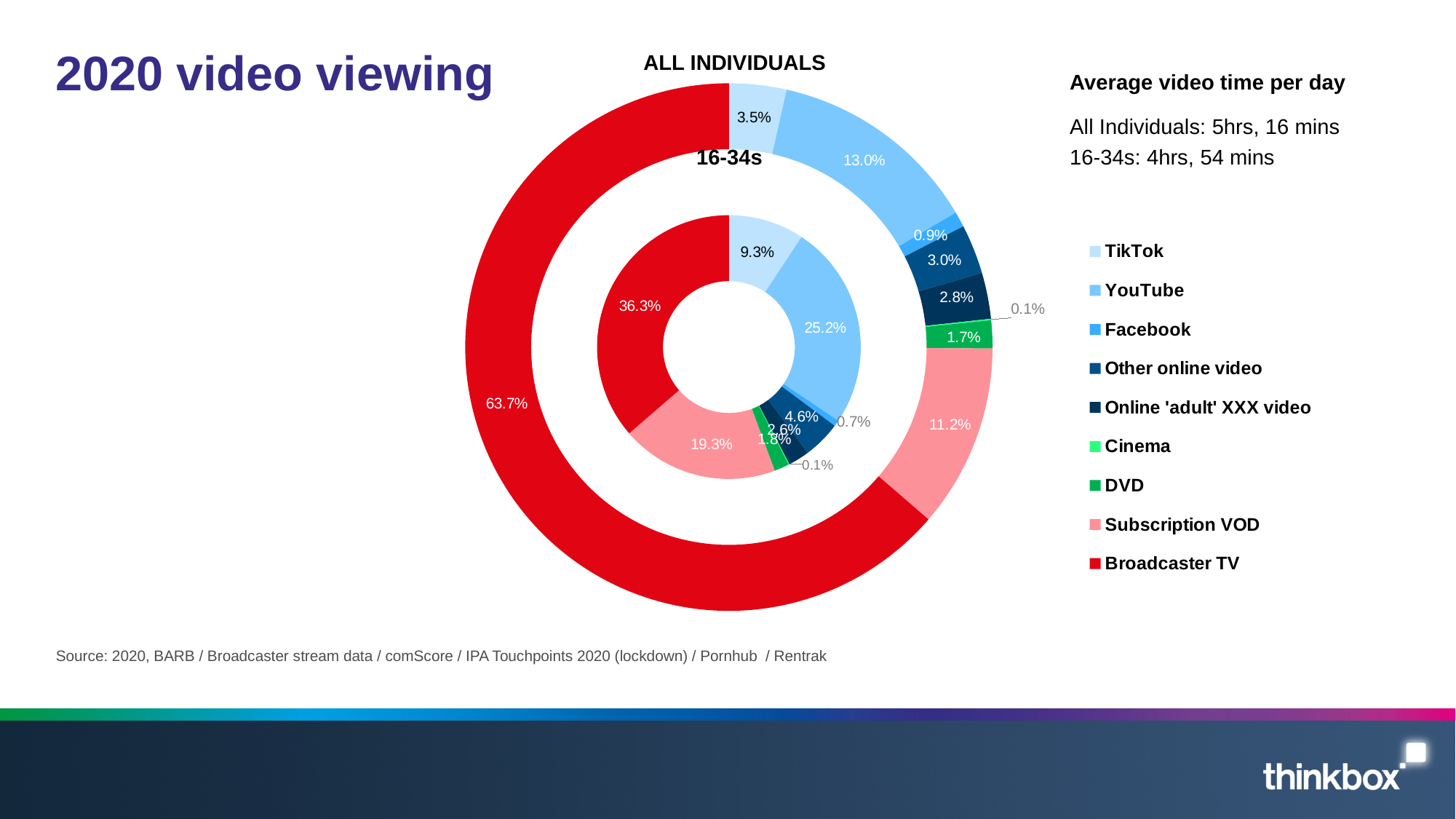
In the 16-34s ring, what share is Subscription VOD? 19.3% In the ALL INDIVIDUALS ring, what share is Broadcaster TV? 63.7% What is the average video time per day for 16-34s stated on the slide? 4hrs, 54 mins Which is larger: the YouTube share for 16-34s or the Subscription VOD share for 16-34s? YouTube What is the difference between the Broadcaster TV share for ALL INDIVIDUALS and for 16-34s? 27.4 percentage points How many categories does the legend list? 9 What kind of chart is shown on the slide? Doughnut chart In the 16-34s ring, what share is YouTube? 25.2% Which category has the largest share in the ALL INDIVIDUALS ring? Broadcaster TV Which group does the inner ring of the chart represent? 16-34s Which category has the smallest share in the 16-34s ring? Cinema In the ALL INDIVIDUALS ring, what share is TikTok? 3.5%